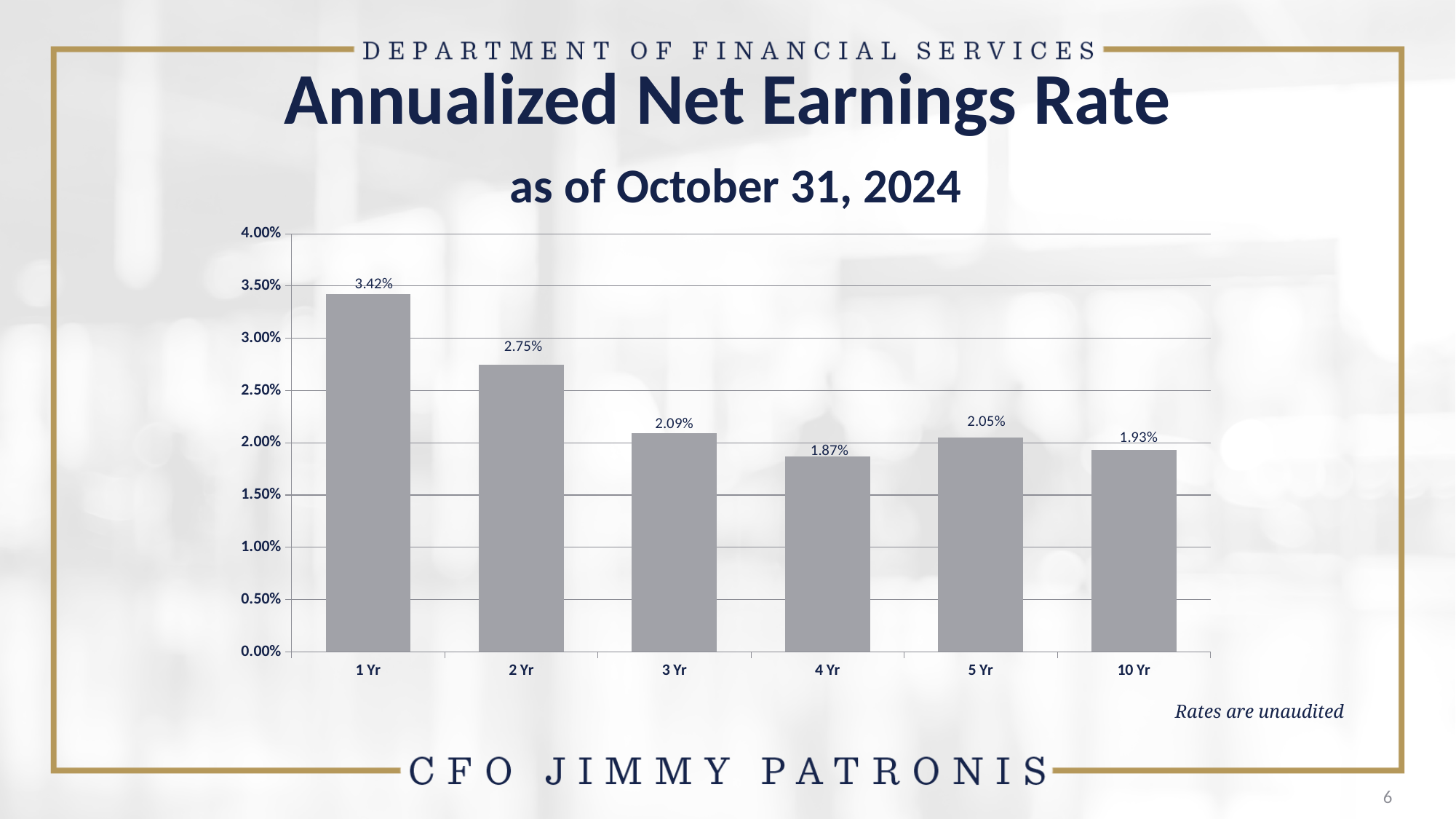
What is the difference between the 1 Yr and 2 Yr annualized net earnings rates? 0.67% What is the annualized net earnings rate for 1 Yr? 3.42% Which period has the highest annualized net earnings rate? 1 Yr Which period has the lowest annualized net earnings rate? 4 Yr How many periods are shown on the x axis of the chart? 6 Do the values generally rise or fall from 1 Yr to 4 Yr? fall Which is larger, the 3 Yr rate or the 5 Yr rate? 3 Yr Is the value for 2 Yr greater or less than 2.50%? greater What date is the annualized net earnings rate reported as of? October 31, 2024 What is the annualized net earnings rate for 4 Yr? 1.87% What is the annualized net earnings rate for 10 Yr? 1.93% What kind of chart is shown on the slide? bar chart